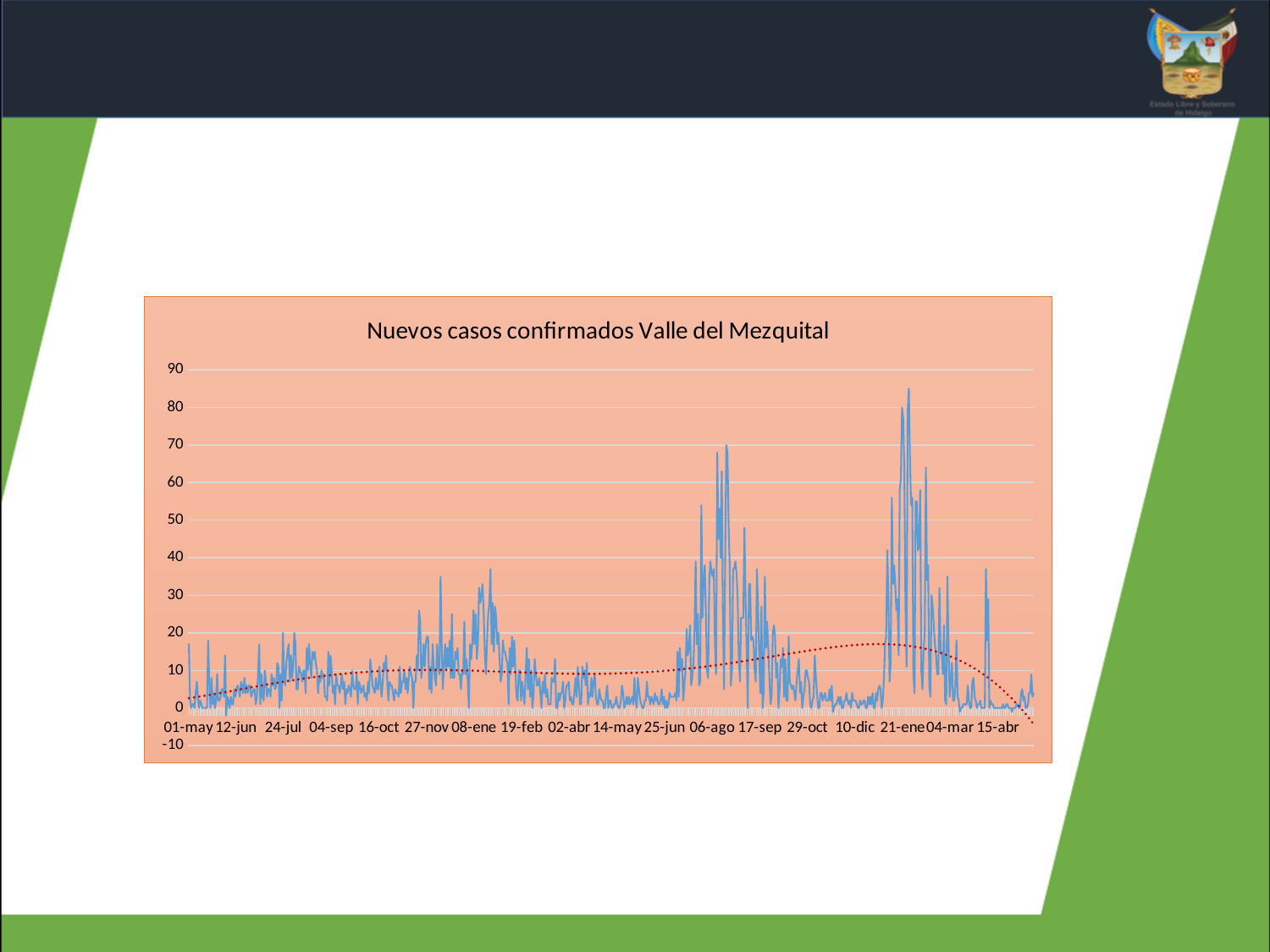
Does the red dotted trend line rise or fall at the far right end of the chart, after 15-abr? Fall Around which x-axis label does the blue line reach its highest peak? 21-ene What is the highest value shown on the vertical axis of the chart? 90 Which is higher: the peak of the blue line near 21-ene or the peak near 06-ago? The peak near 21-ene What is the title of the chart? Nuevos casos confirmados Valle del Mezquital What type of chart is shown on the slide? Line chart Is the highest peak of the blue line, near 21-ene, greater or less than 80? greater Are the values of the blue line around 02-abr greater or less than 20? less Is the peak of the blue line near 08-ene greater or less than 40? less What is the first date label on the x axis of the chart? 01-may How many date labels are shown along the x axis of the chart? 18